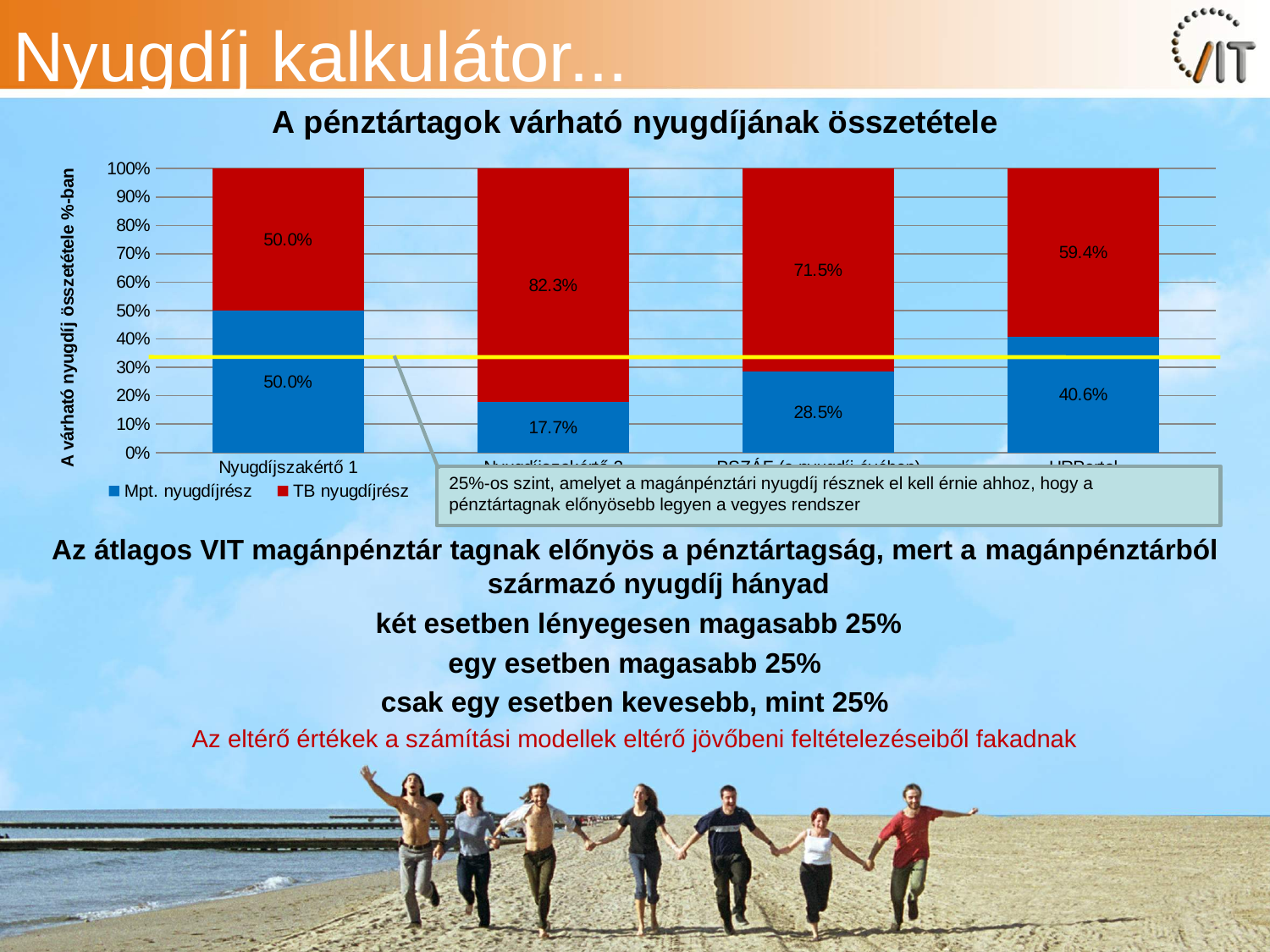
What is the Mpt. nyugdíjrész value shown on the second bar from the left? 17.7% What is the Mpt. nyugdíjrész value for Nyugdíjszakértő 1? 50.0% How many series does the legend list? 2 What is the TB nyugdíjrész value for Nyugdíjszakértő 1? 50.0% What is the TB nyugdíjrész value shown on the second bar from the left? 82.3% In the third bar from the left, how many percentage points larger is the TB nyugdíjrész share than the Mpt. nyugdíjrész share? 43.0 percentage points What is the Mpt. nyugdíjrész value shown on the third bar from the left? 28.5% Which bar has the highest Mpt. nyugdíjrész share? Nyugdíjszakértő 1 What type of chart is shown on the slide? Stacked bar chart What is the TB nyugdíjrész value shown on the rightmost bar? 59.4% Is the Mpt. nyugdíjrész share larger in the rightmost bar or in the third bar from the left? The rightmost bar Which bar has the lowest Mpt. nyugdíjrész share? The second bar from the left